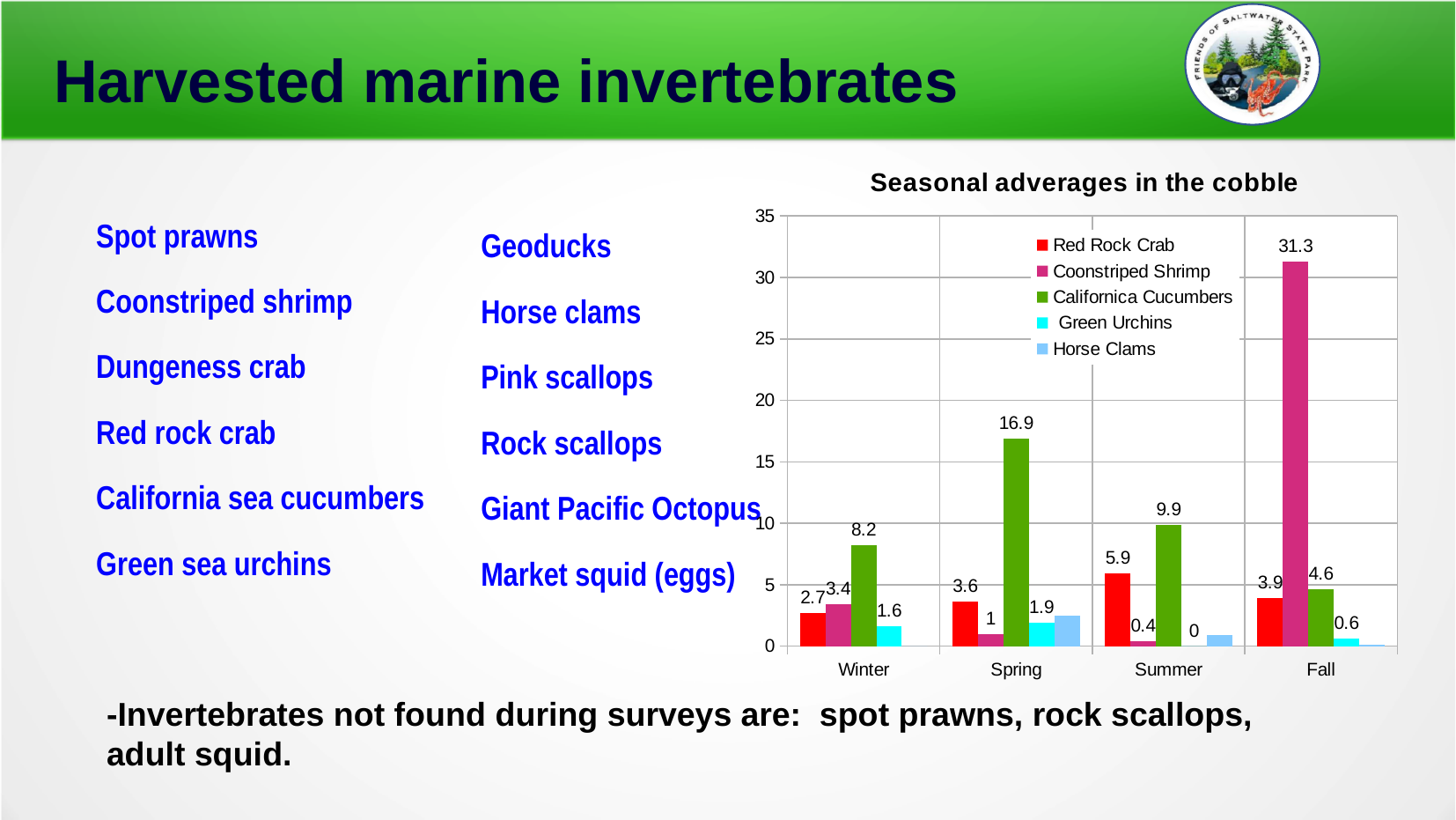
In which season is the Red Rock Crab value highest? Summer What is the difference between the Californica Cucumbers values in Spring and Summer? 7 How many seasons are shown on the x axis? 4 What kind of chart is shown? bar chart In which season is the Californica Cucumbers value lowest? Fall What is the value for Green Urchins in Summer? 0 In Winter, which is larger: Red Rock Crab or Coonstriped Shrimp? Coonstriped Shrimp What is the title of the chart? Seasonal adverages in the cobble Is the value for Horse Clams in Spring greater or less than 5? less How many series does the legend list? 5 What is the value for Coonstriped Shrimp in Fall? 31.3 What is the value for Californica Cucumbers in Spring? 16.9